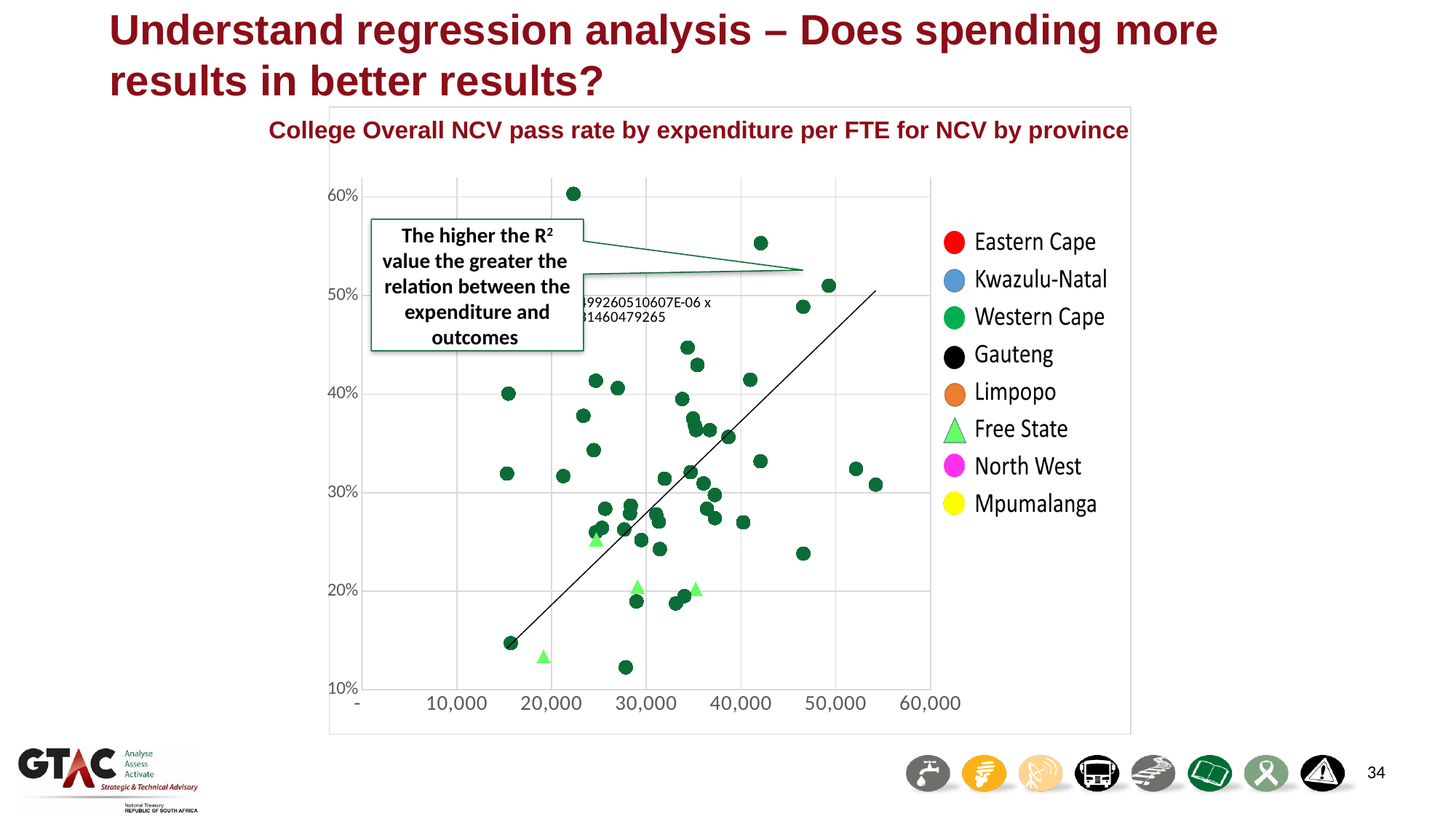
Is the highest pass rate plotted on the chart greater or less than 50%? greater What is the lowest value shown on the vertical axis? 10% What is the largest value shown on the horizontal axis? 60,000 What kind of chart is shown on the slide? scatter chart Does the fitted trend line rise or fall as expenditure per FTE increases? rises Is the pass rate of the Free State point with the lowest pass rate greater or less than 20%? less Is the expenditure per FTE for the point with the highest pass rate greater or less than 30,000? less How many triangle (Free State) points are plotted on the chart? 4 How many provinces does the legend list? 8 What is the title of the chart? College Overall NCV pass rate by expenditure per FTE for NCV by province Which legend entry is shown with a triangle marker instead of a circle? Free State